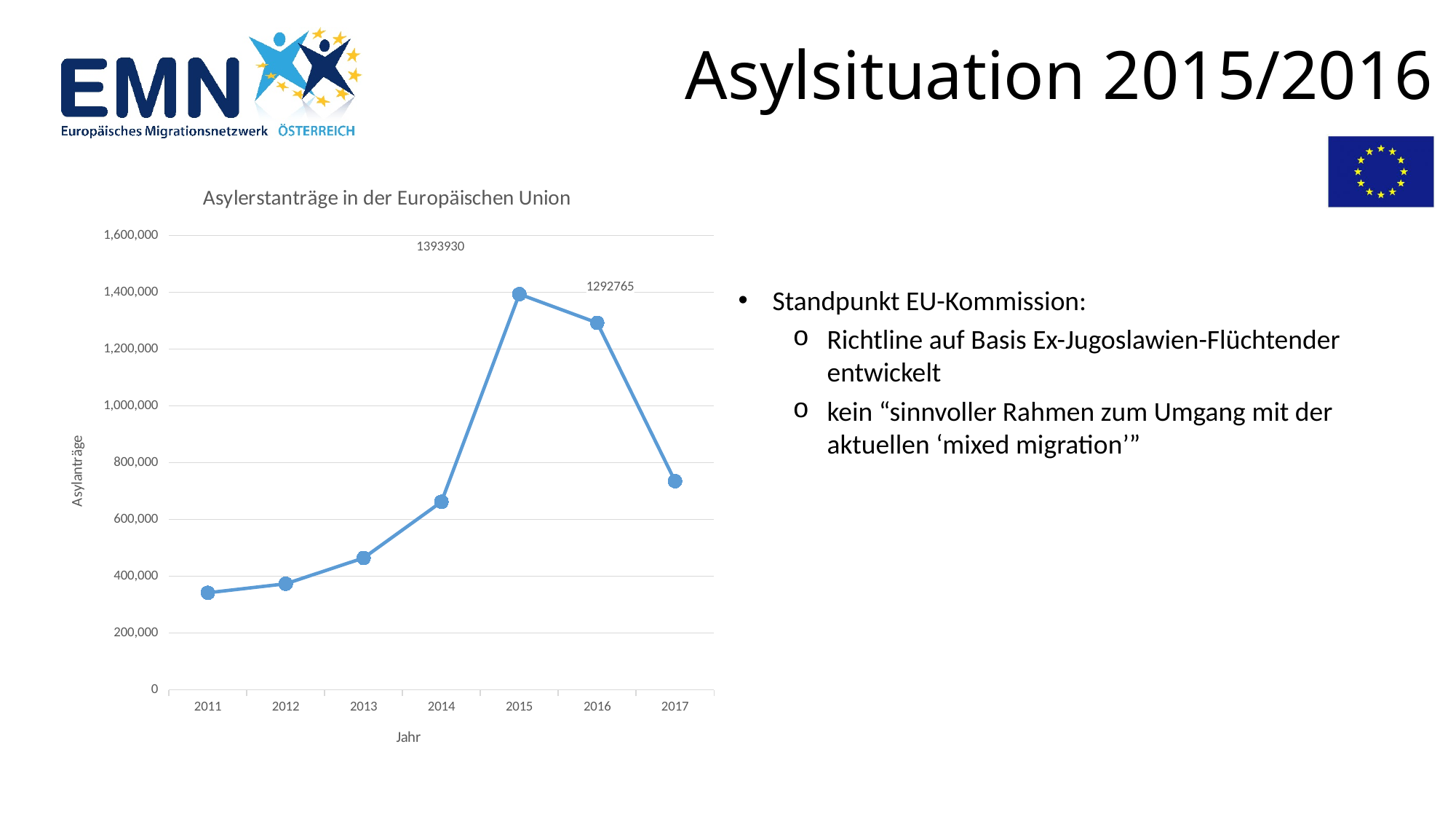
Which year has the lowest number of asylum applications in the chart? 2011 Is the value for 2017 greater or less than 800,000? less What is the difference between the values for 2015 and 2016? 101165 What is the value for 2016 in the chart? 1292765 Is the value for 2011 greater or less than 400,000? less Do the values rise or fall from 2011 to 2015? rise How many years are plotted on the x axis of the chart? 7 What kind of chart is shown on the slide? line chart Which year has the highest number of asylum applications in the chart? 2015 Which is larger, the value for 2015 or the value for 2016? 2015 Is the value for 2014 greater or less than 600,000? greater What is the value for 2015 in the chart? 1393930